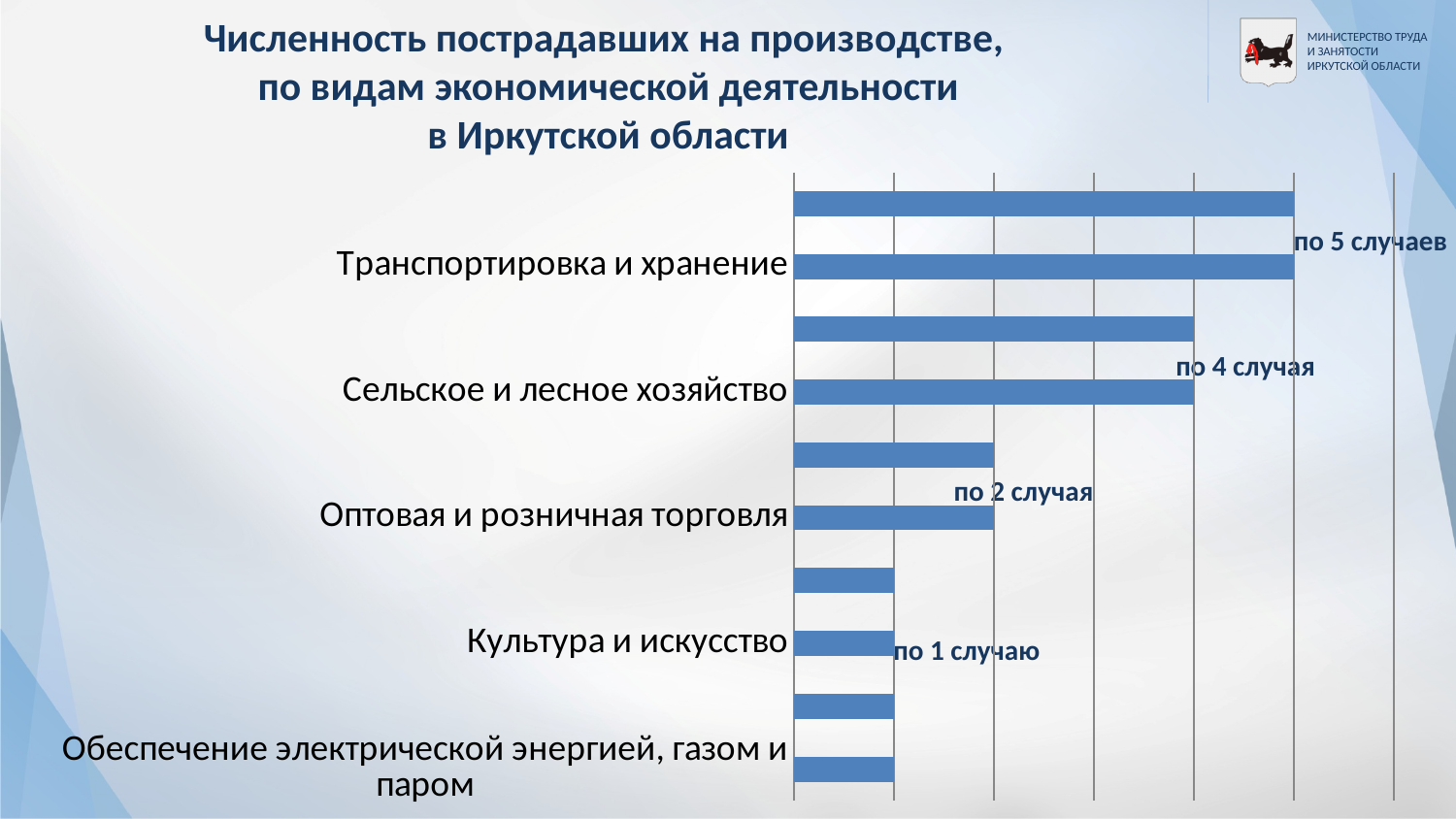
What is the difference in cases between Сельское и лесное хозяйство and Оптовая и розничная торговля? 2 How many cases are shown for Транспортировка и хранение? по 5 случаев What is the title of the chart? Численность пострадавших на производстве, по видам экономической деятельности в Иркутской области Which category has the highest number of cases? Транспортировка и хранение How many cases are shown for Культура и искусство? по 1 случаю What kind of chart is shown on the slide? bar chart How many cases are shown for Оптовая и розничная торговля? по 2 случая How many cases are shown for Сельское и лесное хозяйство? по 4 случая Which has more cases, Оптовая и розничная торговля or Культура и искусство? Оптовая и розничная торговля What is the difference in cases between Транспортировка и хранение and Сельское и лесное хозяйство? 1 Which categories have the lowest number of cases? Культура и искусство and Обеспечение электрической энергией, газом и паром